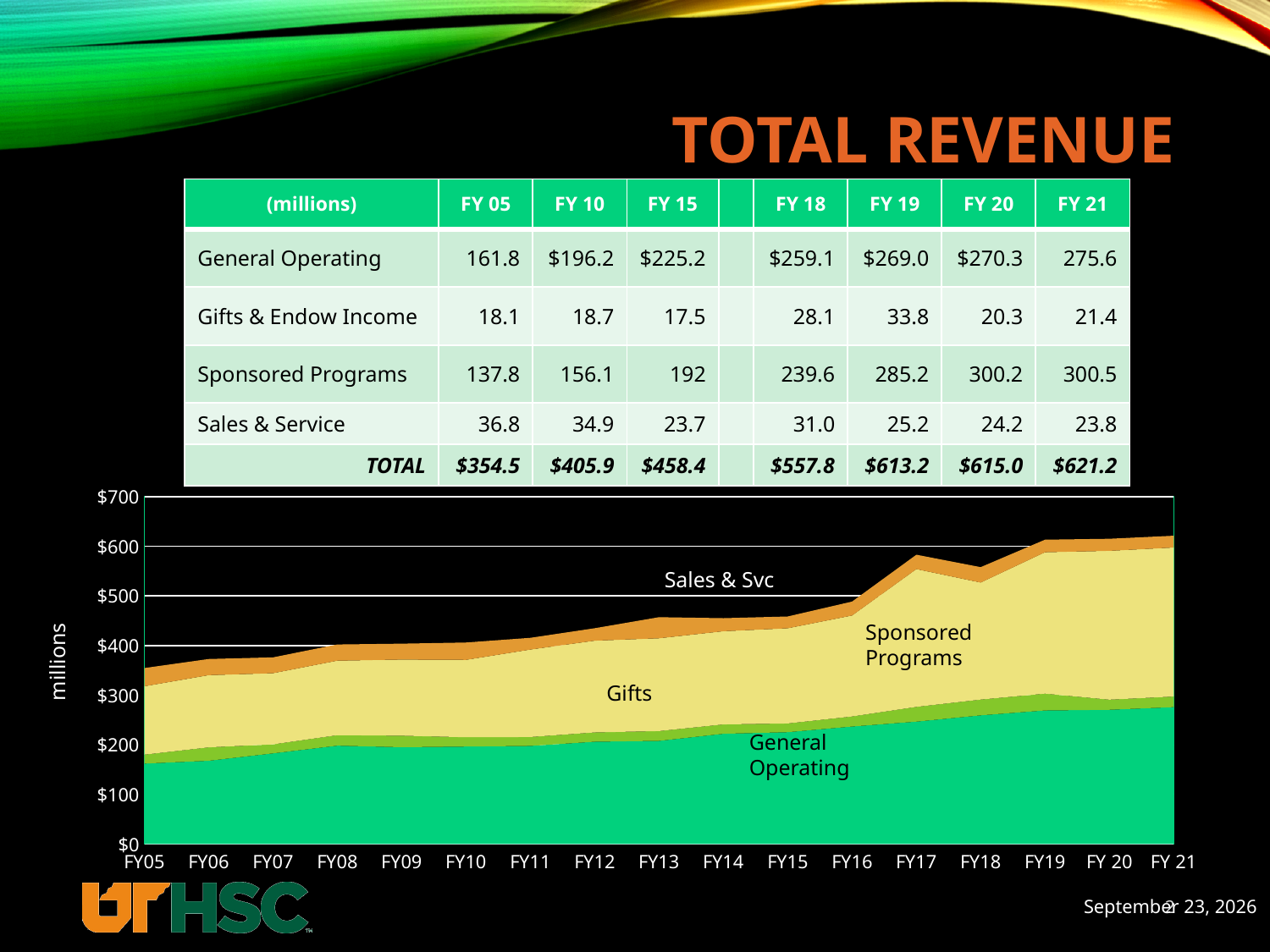
Is the total revenue for FY17 greater or less than $500 million? greater What is the label on the vertical axis of the chart? millions Is the total revenue for FY21 greater or less than $600 million? greater Is the total revenue for FY21 larger or smaller than the total revenue for FY15? larger Does total revenue generally rise or fall from FY05 to FY21 in the chart? Rise Is the total revenue for FY05 greater or less than $400 million? less How many revenue series are stacked in the chart? 4 How many fiscal years are plotted along the x axis of the chart? 17 Which series forms the bottom layer of the stacked area chart? General Operating Which fiscal year has the lowest total revenue in the chart? FY05 What kind of chart is shown on the slide? Stacked area chart